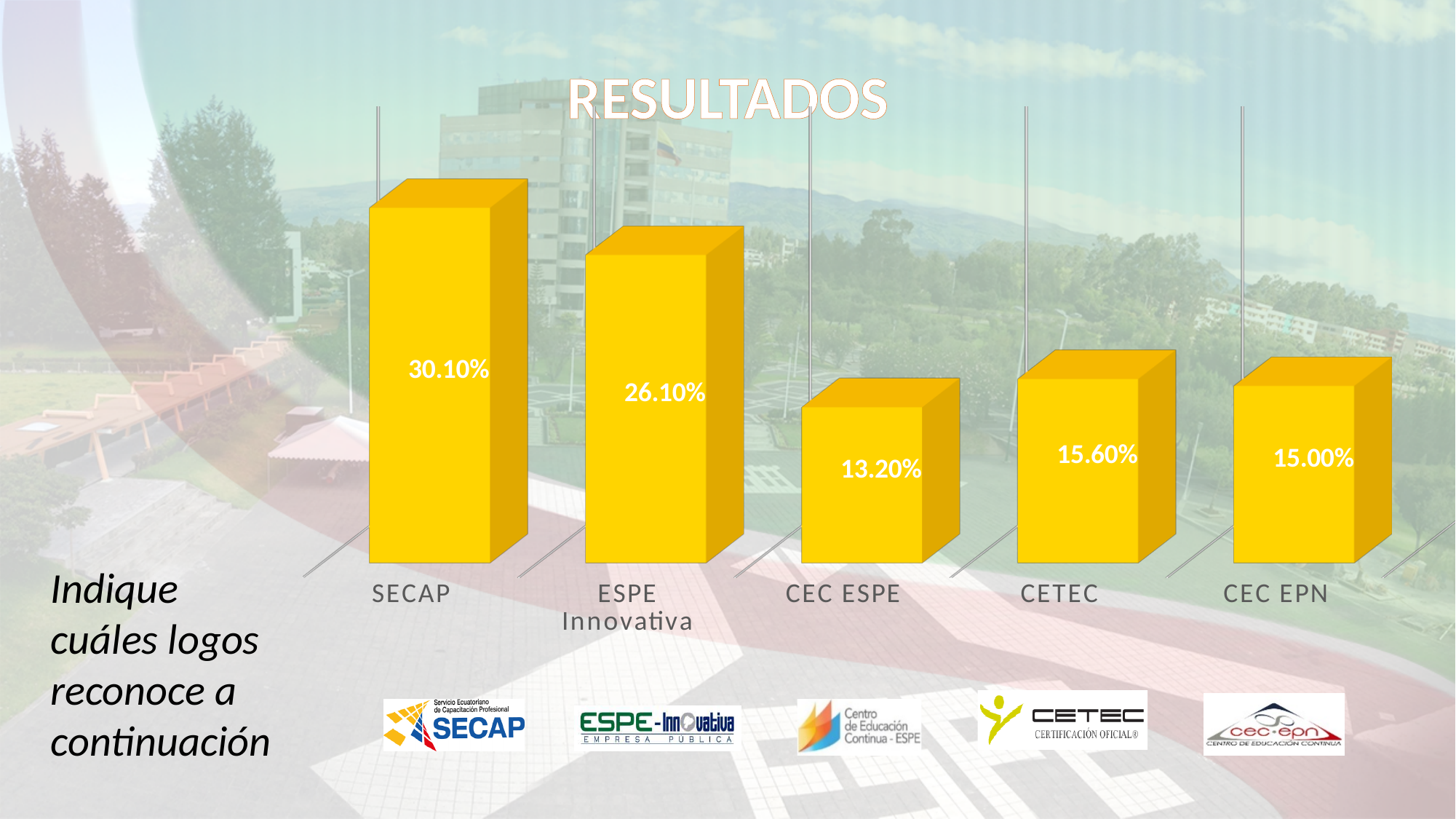
What is the difference between the values for SECAP and ESPE Innovativa? 4.00% What is the title of the chart? RESULTADOS What kind of chart is shown on the slide? Bar chart What is the value for CETEC? 15.60% How many categories are shown in the chart? 5 Which category has the lowest value? CEC ESPE What is the value for CEC ESPE? 13.20% Which is larger, the value for CETEC or the value for CEC ESPE? CETEC What is the value for CEC EPN? 15.00% What is the value for ESPE Innovativa? 26.10% Which category has the highest value? SECAP What is the value for SECAP? 30.10%